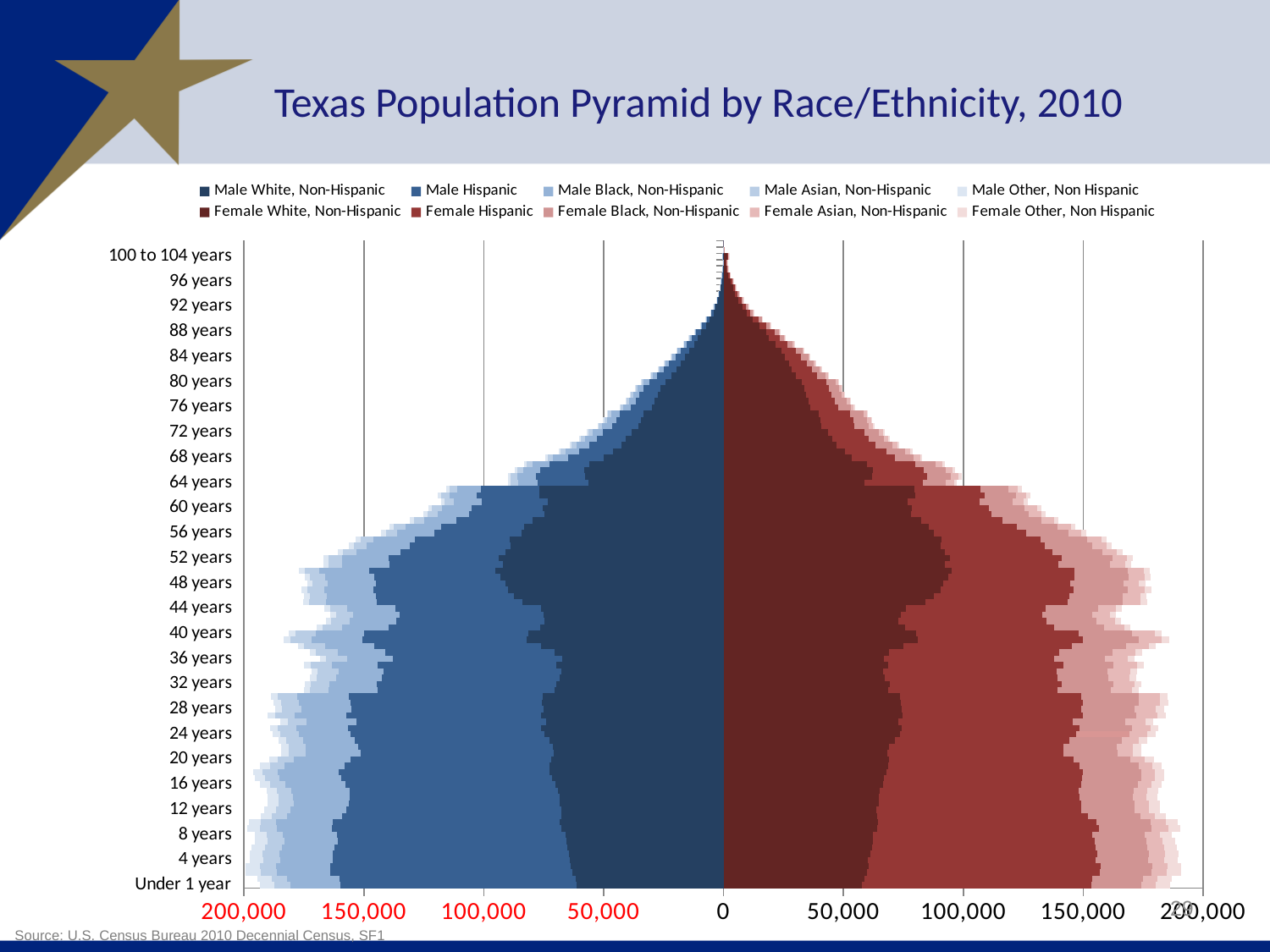
What kind of chart is shown on the slide? Bar chart (population pyramid) Is the total male population for the 100 to 104 years group greater or less than 50,000? less Is the total female population for the 64 years group greater or less than 150,000? less Which side of the chart shows the male population, the left or the right? Left What is the title of the chart? Texas Population Pyramid by Race/Ethnicity, 2010 How many series does the legend list? 10 Is the total male population for the 40 years group greater or less than 150,000? greater Which age group has a longer total male bar, 40 years or 84 years? 40 years Do the bars generally get shorter or longer as age increases from Under 1 year to 100 to 104 years? shorter